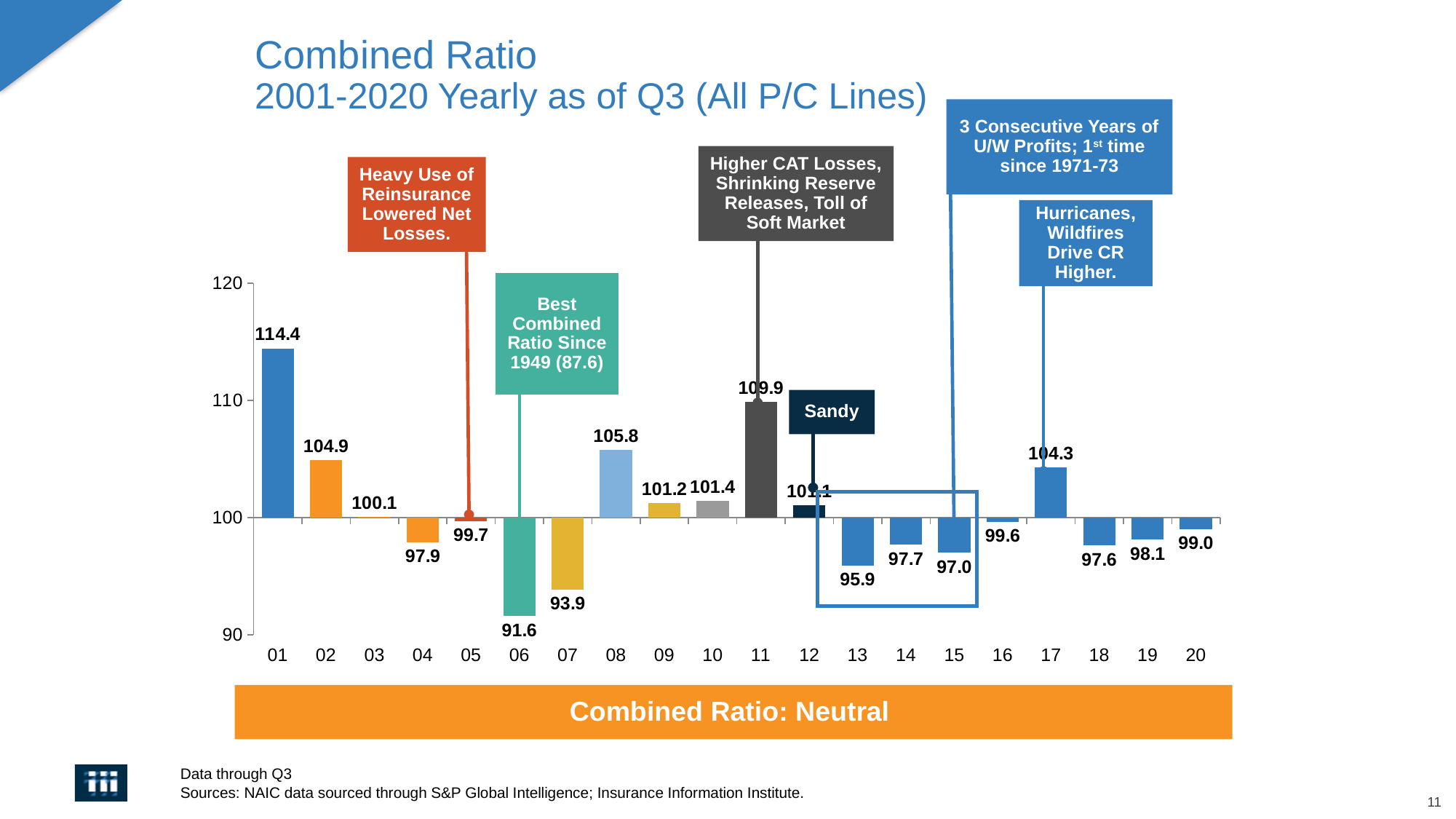
Is the combined ratio for 2013 greater or less than 100? less Does the combined ratio rise or fall from 2001 to 2004? fall What is the combined ratio for 2006 (06)? 91.6 What is the combined ratio for 2020 (20)? 99.0 What is the difference between the combined ratio in 2001 (114.4) and in 2006 (91.6)? 22.8 How many years are plotted on the chart? 20 What is the combined ratio for 2001 (01)? 114.4 Which year has the highest combined ratio? 01 What is the combined ratio for 2017 (17)? 104.3 What kind of chart is shown on the slide? bar chart Which year has the lowest combined ratio? 06 Which year has the larger combined ratio, 2008 or 2011? 11